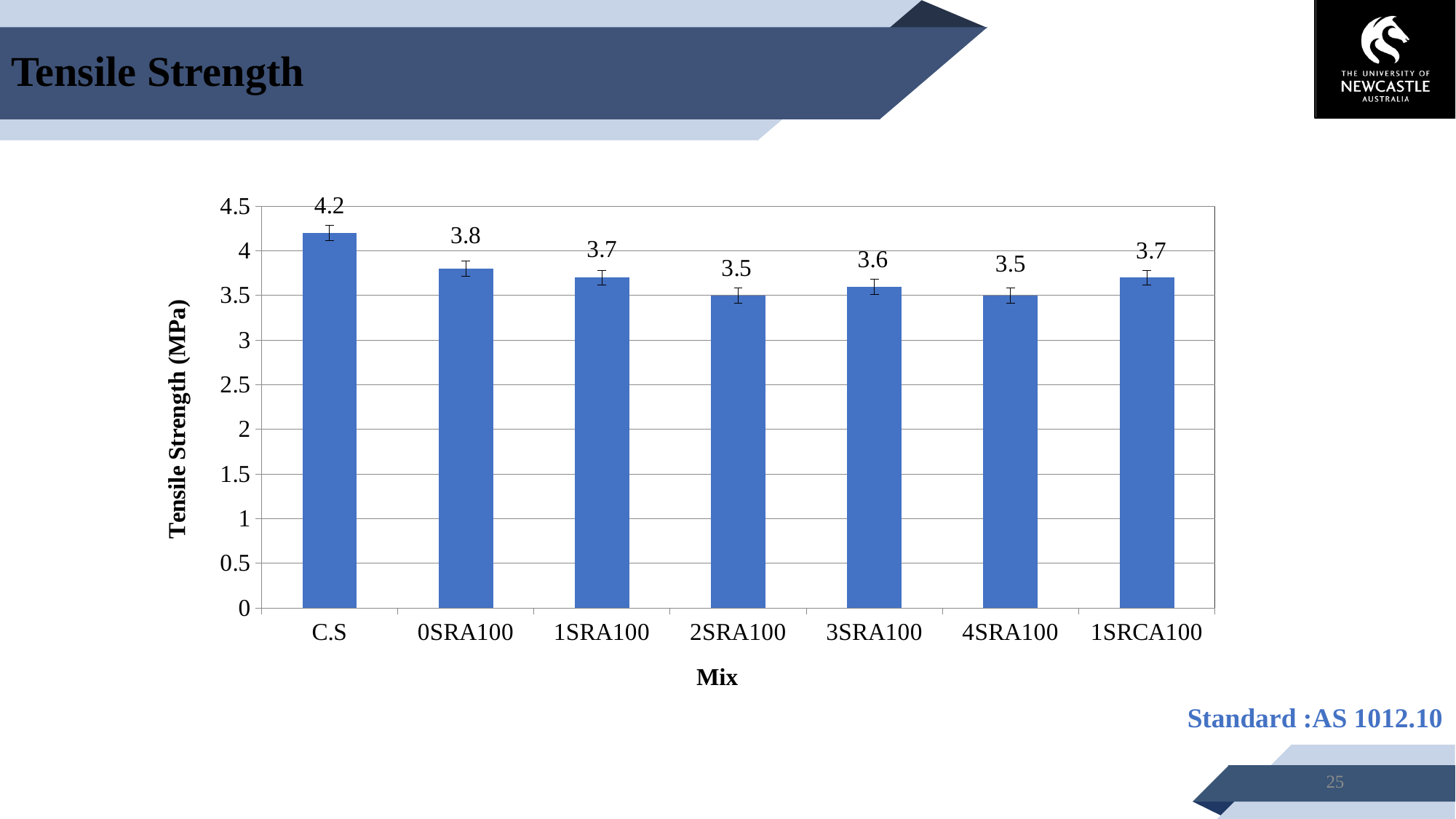
What is the tensile strength for 0SRA100? 3.8 What is the difference in tensile strength between C.S and 2SRA100? 0.7 How many mixes are shown on the x axis? 7 Which has a higher tensile strength, 0SRA100 or 4SRA100? 0SRA100 What is the tensile strength for 1SRCA100? 3.7 Which mix has the highest tensile strength? C.S Is the tensile strength for C.S greater or less than 4? greater What kind of chart is shown on the slide? Bar chart What is the label of the y axis? Tensile Strength (MPa) What is the tensile strength for 3SRA100? 3.6 What is the tensile strength for C.S? 4.2 What is the difference in tensile strength between C.S and 0SRA100? 0.4